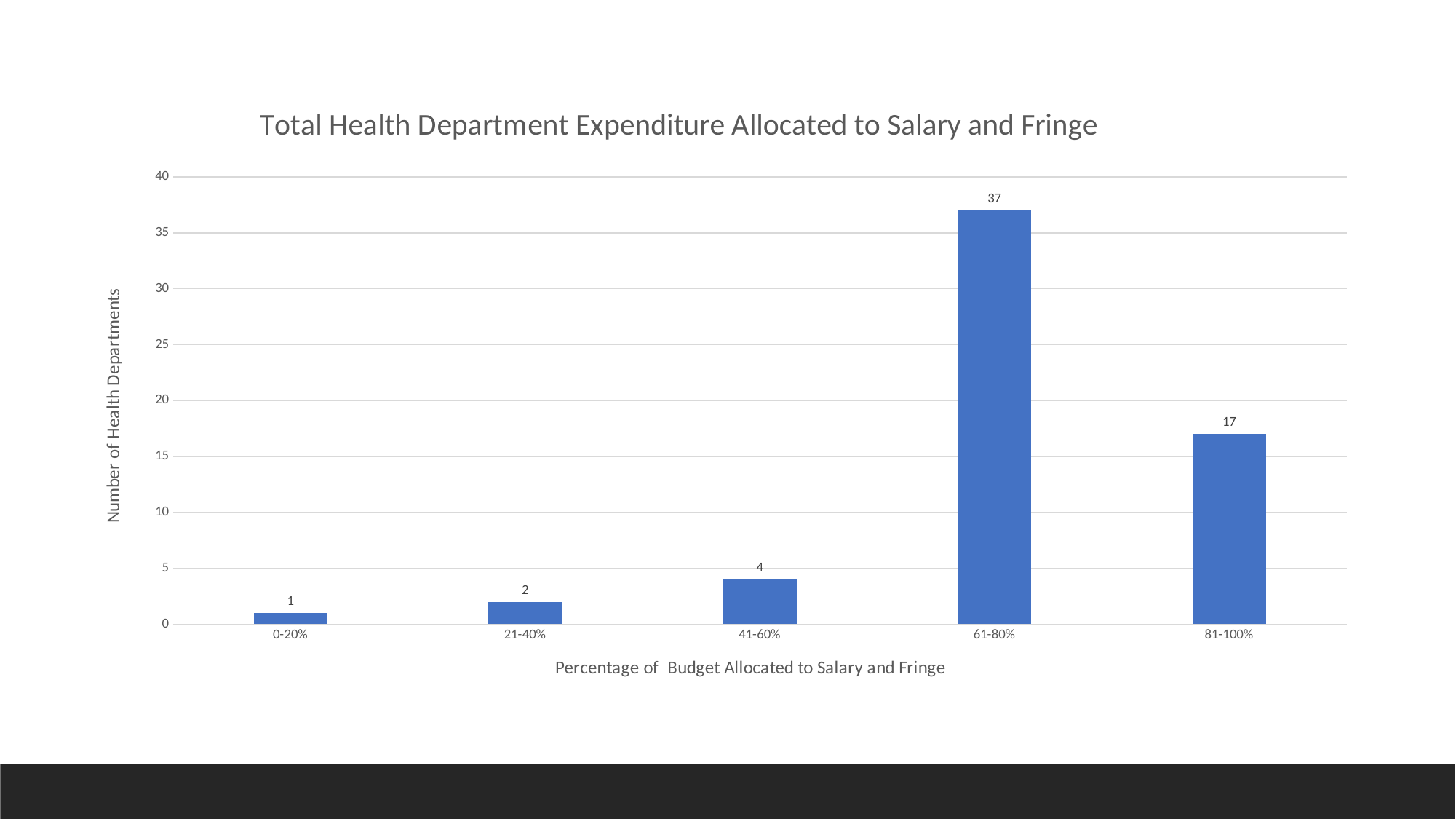
What is the label of the y axis? Number of Health Departments What is the value for the 41-60% category? 4 What is the difference between the number of health departments in the 61-80% and 81-100% categories? 20 Is the value for the 81-100% category greater or less than 20? less What is the number of health departments in the 81-100% category? 17 Which percentage category has the highest number of health departments? 61-80% What is the title of the chart? Total Health Department Expenditure Allocated to Salary and Fringe How many percentage categories are shown on the x axis? 5 Which has more health departments, the 21-40% category or the 41-60% category? 41-60% How many health departments allocate 61-80% of their budget to salary and fringe? 37 Which percentage category has the lowest number of health departments? 0-20% What kind of chart is shown on the slide? bar chart